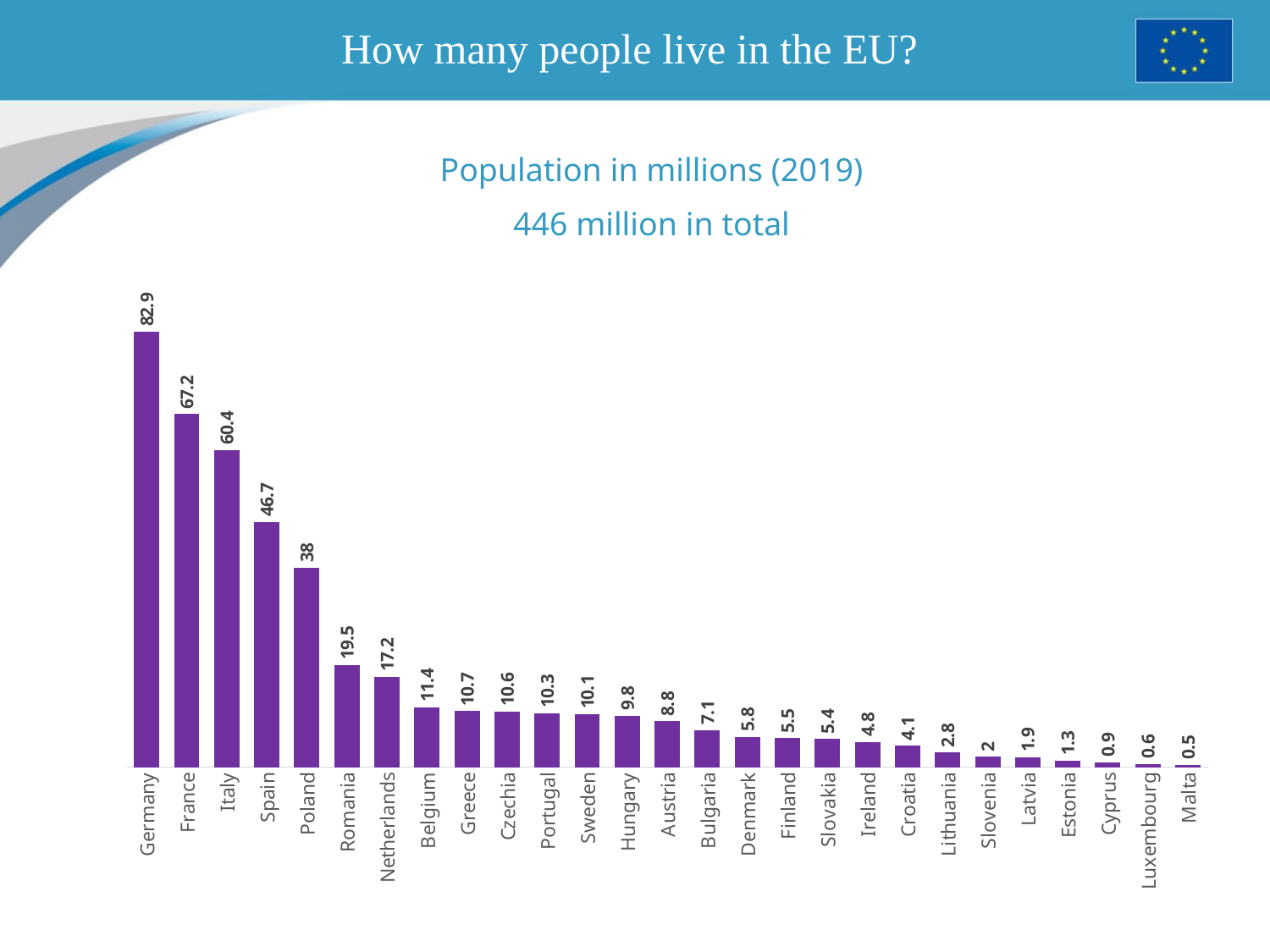
Do the values rise or fall from left to right along the x axis? Fall What kind of chart is shown on the slide? Bar chart How many countries are shown in the chart? 27 What is the title of the chart? Population in millions (2019) What is the population value shown for Luxembourg? 0.6 Which country has the highest population in the chart? Germany What is the population value shown for Poland? 38 What is the population value shown for Netherlands? 17.2 Which country has the lowest population in the chart? Malta What is the difference between the values for France and Italy? 6.8 Which has a larger value, Spain or Poland? Spain What is the population value shown for Germany? 82.9